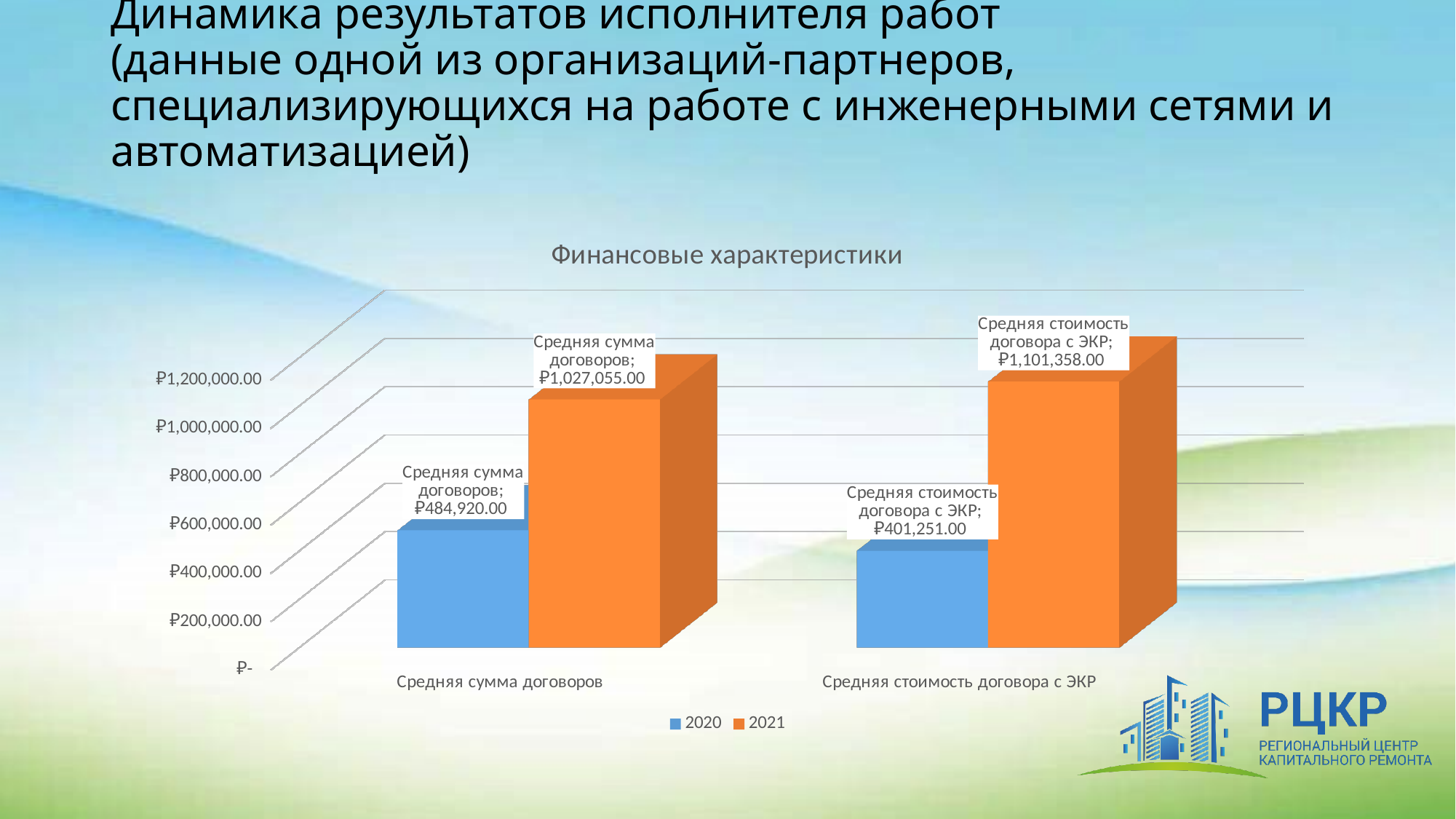
What is the difference between the 2021 and 2020 values for 'Средняя сумма договоров'? ₽542,135.00 What is the value for 'Средняя стоимость договора с ЭКР' in 2020? ₽401,251.00 What is the value for 'Средняя сумма договоров' in 2020? ₽484,920.00 What is the value for 'Средняя сумма договоров' in 2021? ₽1,027,055.00 How many categories are shown on the x axis of the chart? 2 What is the value for 'Средняя стоимость договора с ЭКР' in 2021? ₽1,101,358.00 Which category has the lowest value in the 2020 series? Средняя стоимость договора с ЭКР How many series does the chart legend list? 2 What type of chart is shown on the slide? Bar chart What is the title of the chart? Финансовые характеристики Which series is shown in orange in the chart? 2021 Which category has the highest value in the 2021 series? Средняя стоимость договора с ЭКР